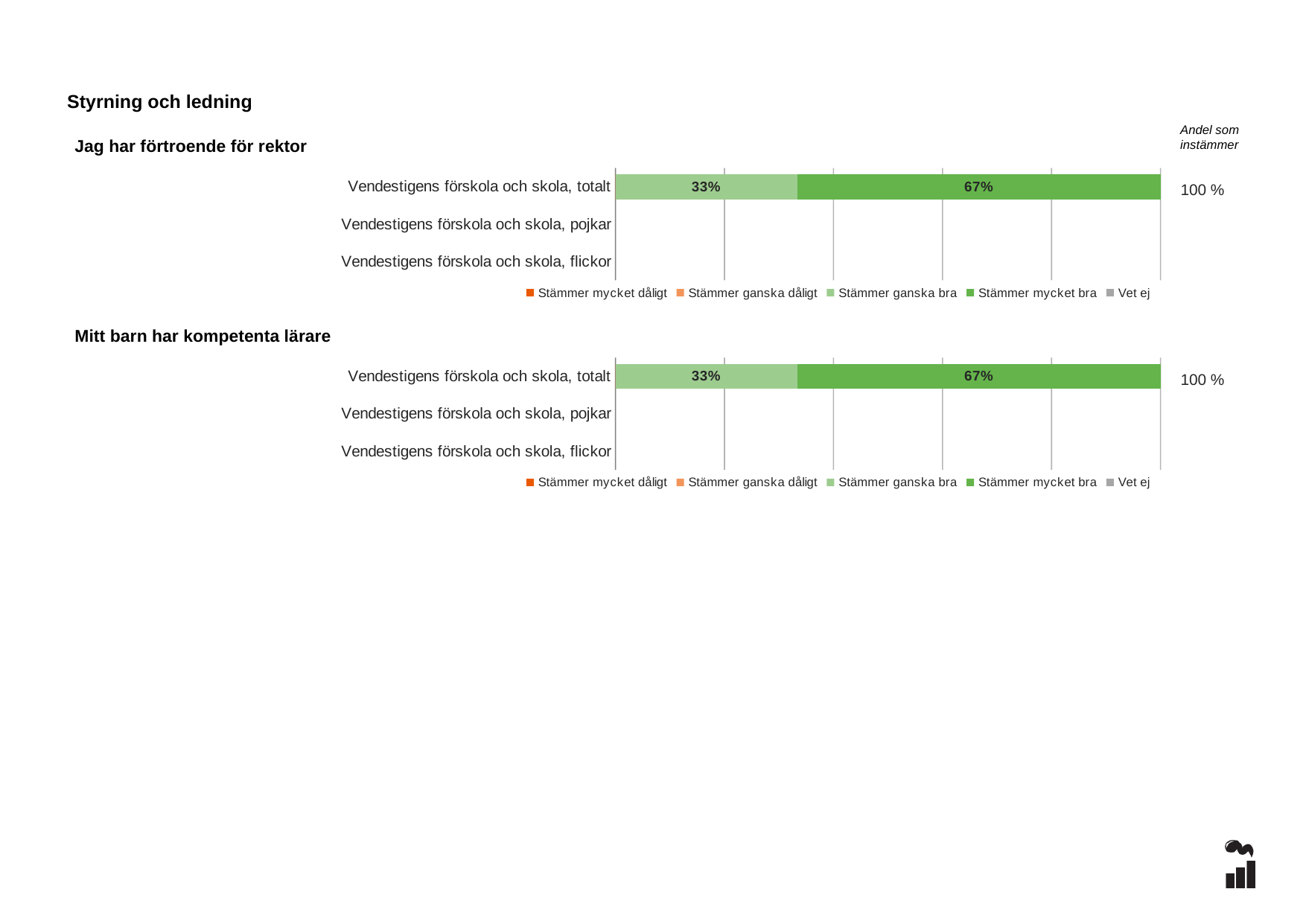
In the chart 'Jag har förtroende för rektor', what is the value of 'Stämmer ganska bra' for 'Vendestigens förskola och skola, totalt'? 33% In the chart 'Mitt barn har kompetenta lärare', what is the value of 'Stämmer mycket bra' for 'Vendestigens förskola och skola, totalt'? 67% In the chart 'Mitt barn har kompetenta lärare', what is the total of the stacked bar for 'Vendestigens förskola och skola, totalt'? 100% In the chart 'Jag har förtroende för rektor', what is the 'Andel som instämmer' value shown for 'Vendestigens förskola och skola, totalt'? 100 % What kind of chart is 'Jag har förtroende för rektor'? Stacked bar chart In the chart 'Jag har förtroende för rektor', what is the value of 'Stämmer mycket bra' for 'Vendestigens förskola och skola, totalt'? 67% How many series does the legend of the chart 'Jag har förtroende för rektor' list? 5 In the chart 'Mitt barn har kompetenta lärare', what is the value of 'Stämmer ganska bra' for 'Vendestigens förskola och skola, totalt'? 33% How many categories are shown on the y axis of the chart 'Mitt barn har kompetenta lärare'? 3 In the chart 'Jag har förtroende för rektor', what is the difference between 'Stämmer mycket bra' and 'Stämmer ganska bra' for 'Vendestigens förskola och skola, totalt'? 34% What is the first legend entry in the chart 'Mitt barn har kompetenta lärare'? Stämmer mycket dåligt In the chart 'Jag har förtroende för rektor', which is larger for 'Vendestigens förskola och skola, totalt': 'Stämmer ganska bra' or 'Stämmer mycket bra'? Stämmer mycket bra